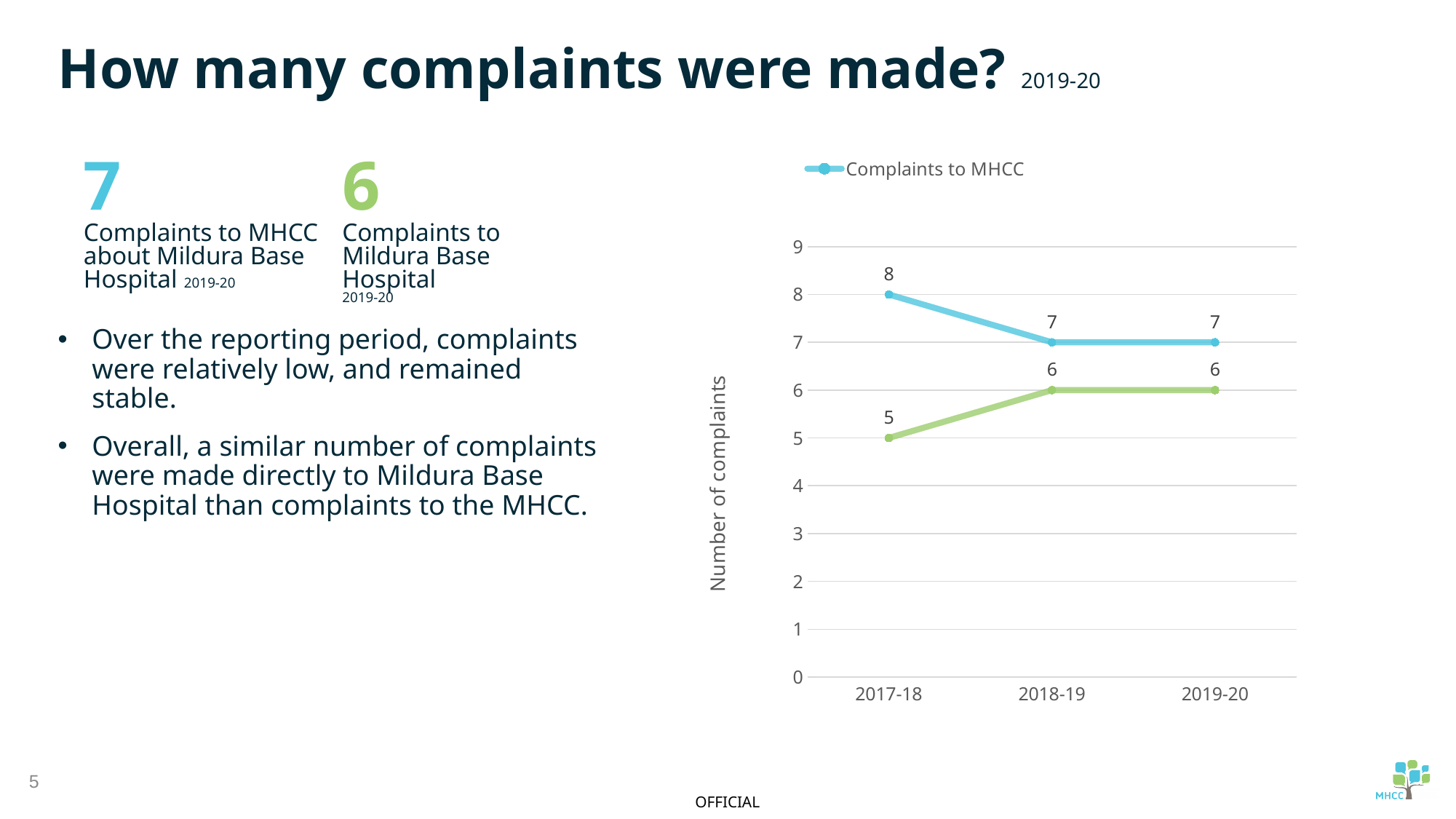
In 2017-18, what is the difference between Complaints to MHCC and the green line's value? 3 In which year were Complaints to MHCC highest? 2017-18 How many years are shown on the x axis of the chart? 3 What is the value of the green line in 2018-19? 6 In 2019-20, which line has the larger value, the blue Complaints to MHCC line or the green line? Complaints to MHCC (blue) What is the title of the y axis of the chart? Number of complaints What is the value of the green line in 2017-18? 5 What type of chart is shown on the slide? Line chart By how much did Complaints to MHCC change from 2017-18 to 2018-19? 1 What is the value for Complaints to MHCC in 2019-20? 7 In which year is the green line at its lowest value? 2017-18 How many Complaints to MHCC were there in 2017-18? 8